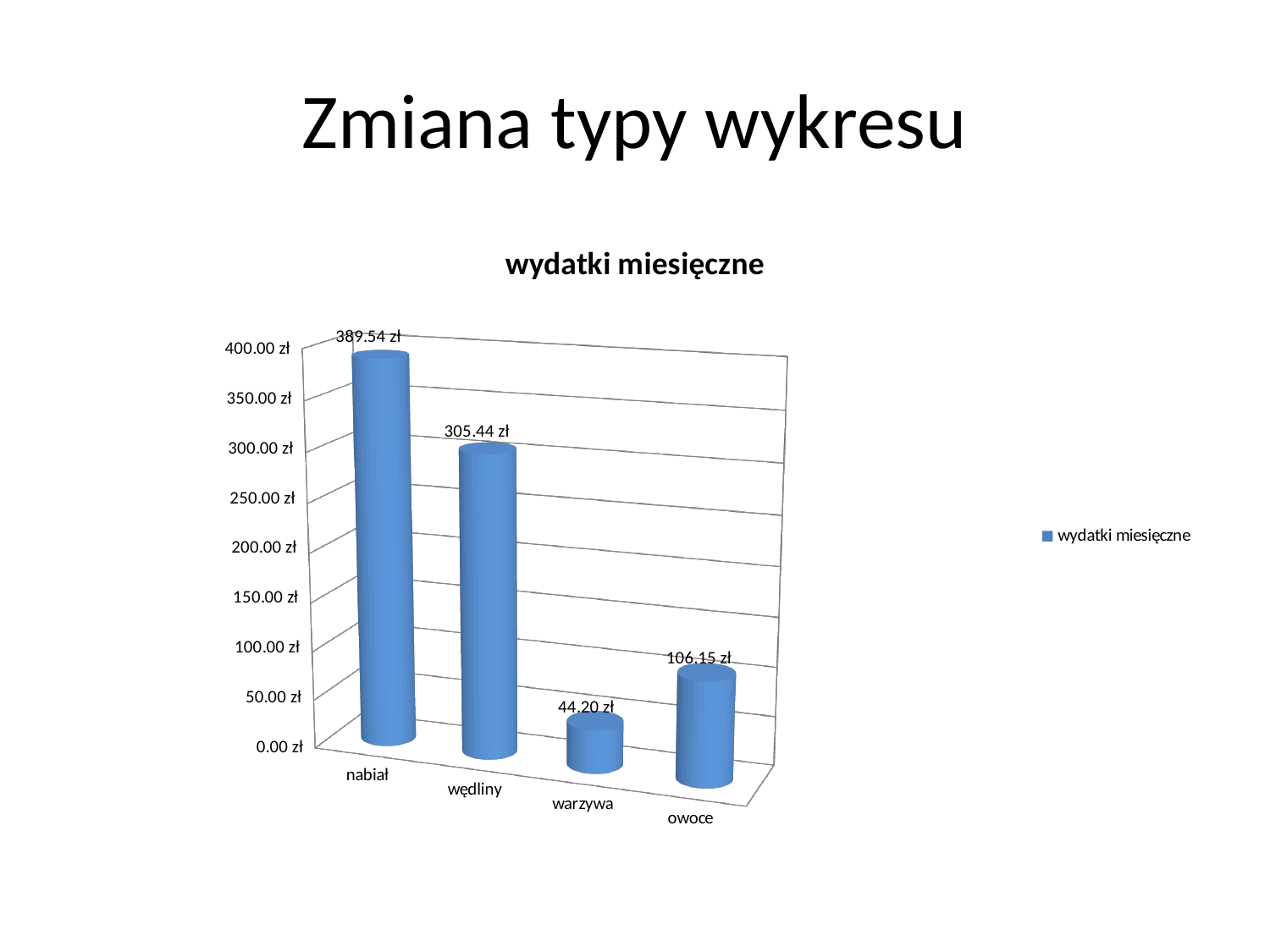
Is the value for wędliny greater or less than 300.00 zł? greater What is the title of the chart? wydatki miesięczne Which category has the highest value? nabiał What is the value for warzywa? 44.20 zł What is the value for wędliny? 305.44 zł What kind of chart is shown? bar chart What is the difference between the values for nabiał and wędliny? 84.10 zł What is the value for owoce? 106.15 zł How many categories are shown on the x axis? 4 Which category has the lowest value? warzywa Which is larger, the value for owoce or the value for warzywa? owoce What is the value for nabiał? 389.54 zł